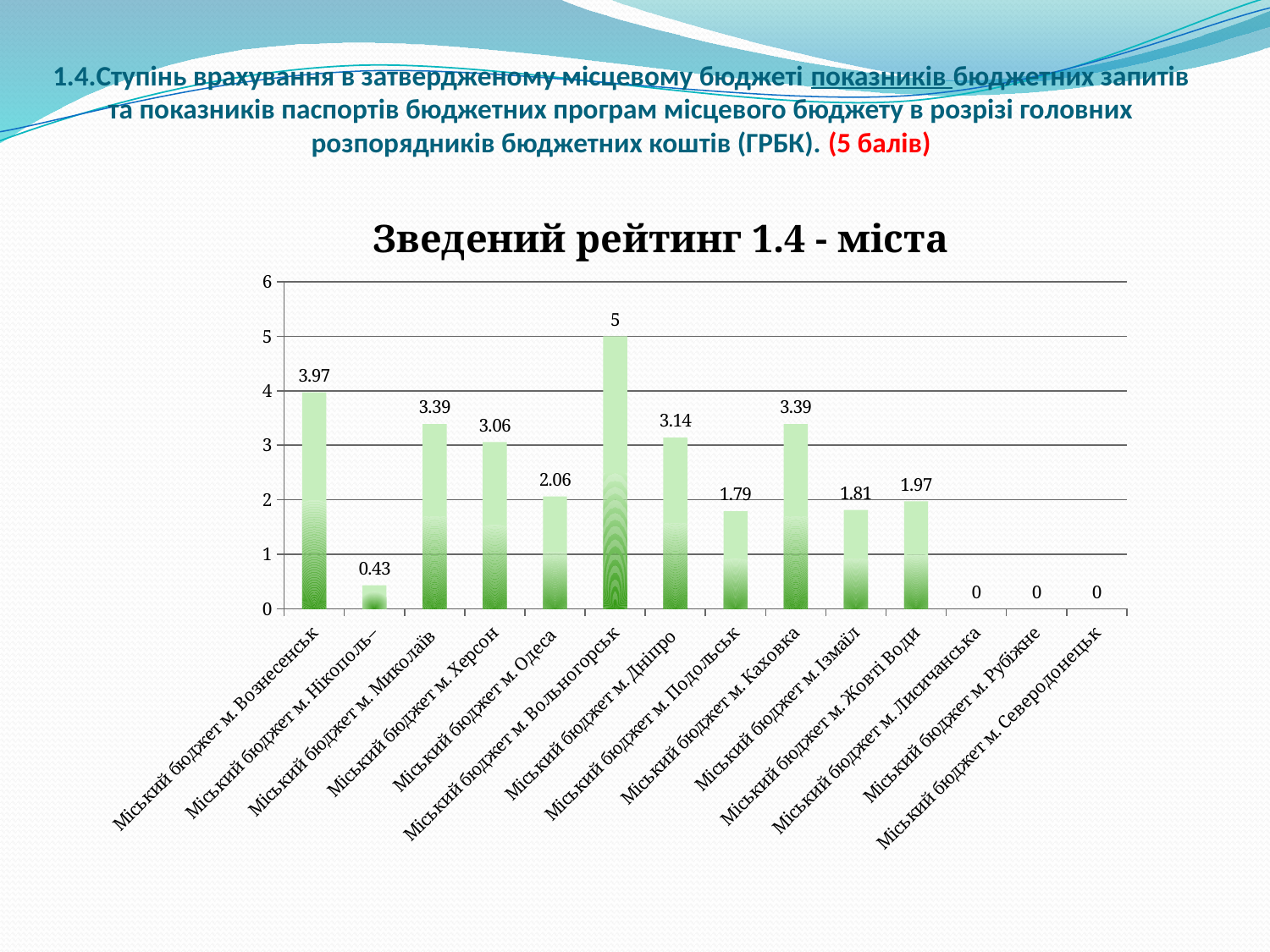
Is the value for Міський бюджет м. Ізмаїл greater or less than 2? less What is the title of the chart? Зведений рейтинг 1.4 - міста How many categories are shown on the x axis? 14 What kind of chart is shown on the slide? bar chart Which is larger, the value for Міський бюджет м. Одеса or the value for Міський бюджет м. Подольськ? Міський бюджет м. Одеса What is the value for Міський бюджет м. Дніпро? 3.14 What is the value for Міський бюджет м. Нікополь? 0.43 What is the difference between the values for Міський бюджет м. Вольногорськ and Міський бюджет м. Каховка? 1.61 What is the difference between the values for Міський бюджет м. Вознесенськ and Міський бюджет м. Херсон? 0.91 Which category has the highest value? Міський бюджет м. Вольногорськ What is the value for Міський бюджет м. Вознесенськ? 3.97 What is the value for Міський бюджет м. Жовті Води? 1.97